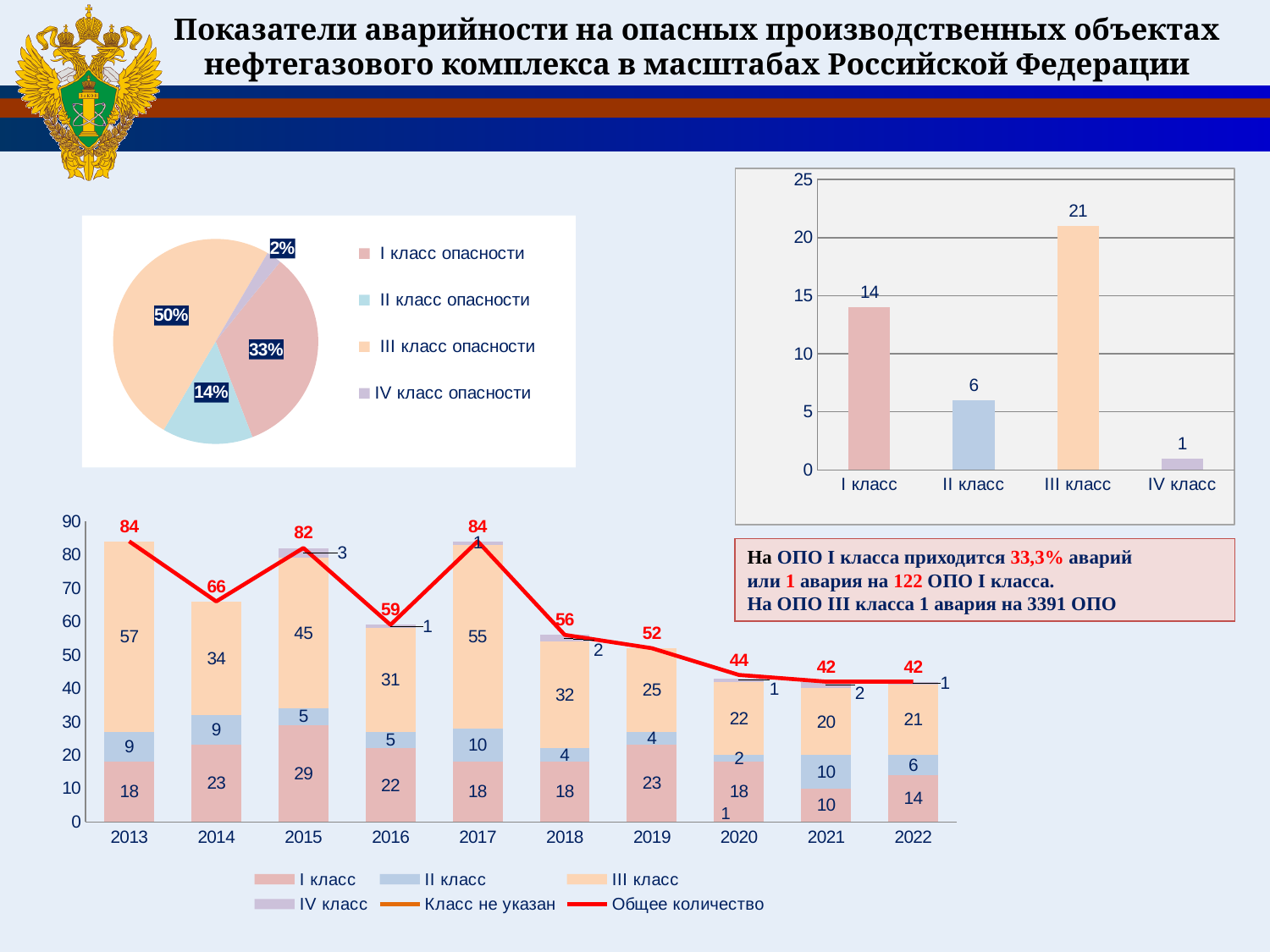
In the stacked bar chart at the bottom, what is the total (Общее количество) for 2013? 84 In the pie chart on the left, what is the share for I класс опасности? 33% In the bar chart at the top right, what is the value for III класс? 21 In the bar chart at the top right, which category has the lowest value? IV класс In the bar chart at the top right, how many categories are shown on the x axis? 4 In the stacked bar chart at the bottom, which year has the larger total, 2014 or 2016? 2014 In the stacked bar chart at the bottom, how many series does the legend list? 6 What kind of chart is the chart at the top right of the slide? bar chart In the pie chart on the left, what share of the pie does III класс опасности have? 50% In the stacked bar chart at the bottom, what is the value for I класс in 2015? 29 In the bar chart at the top right, what is the difference between the values for III класс and I класс? 7 In the pie chart on the left, which category has the smallest slice? IV класс опасности